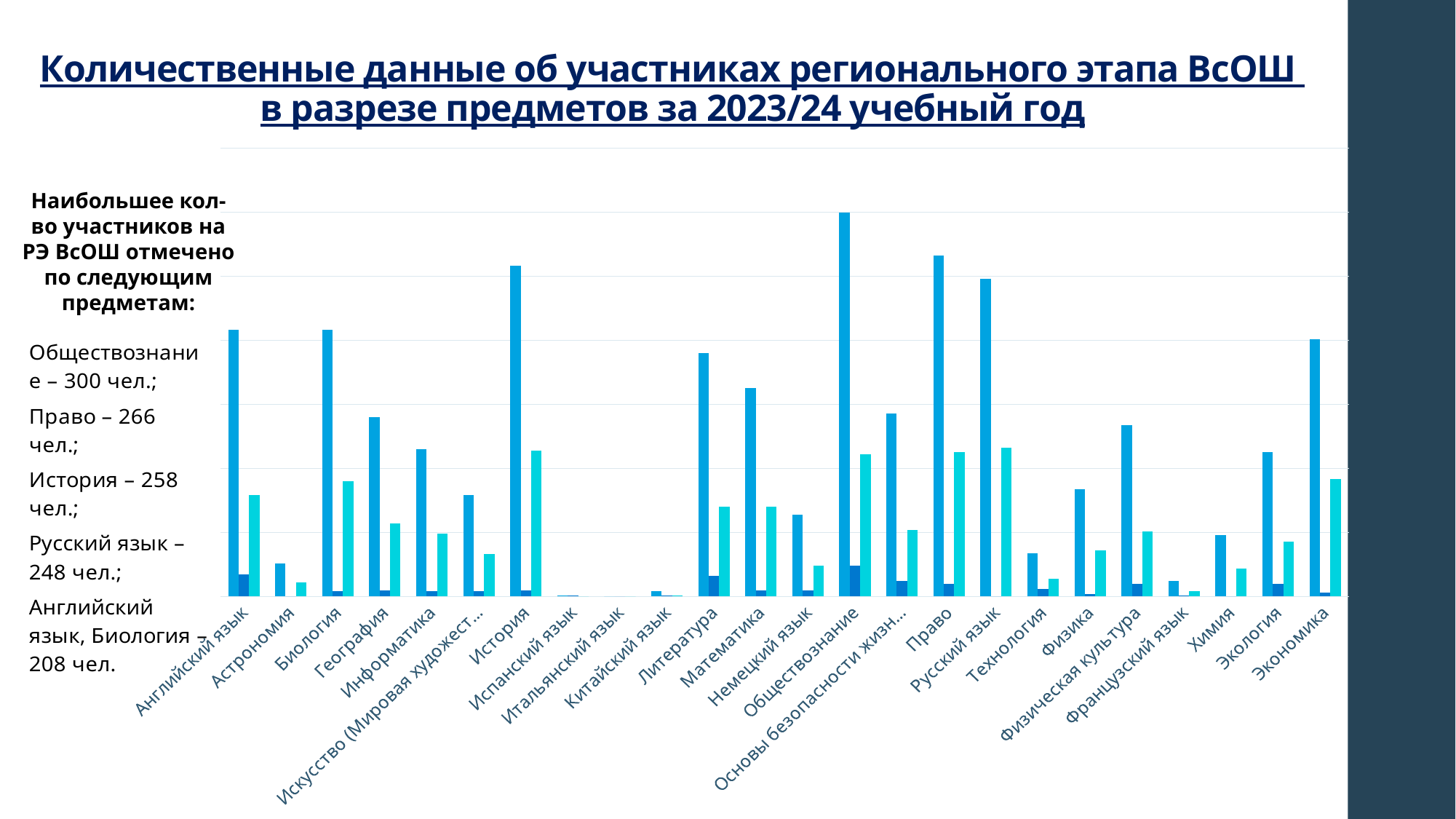
According to the slide, how many participants took part in Право? 266 чел. Which has the taller main bar, Экономика or Экология? Экономика According to the slide, how many participants took part in История? 258 чел. Which has the taller main bar, Литература or Математика? Литература According to the slide, how many participants took part in Русский язык? 248 чел. What is the difference in participants between Право and История? 8 According to the slide, how many participants took part in Обществознание? 300 чел. How many subjects (categories) are shown along the x axis of the chart? 24 What kind of chart is shown on the slide? Bar chart How many bars are plotted for each subject in the chart? 3 What is the difference in participants between Обществознание and Русский язык? 52 Which subject has the tallest bar in the chart? Обществознание